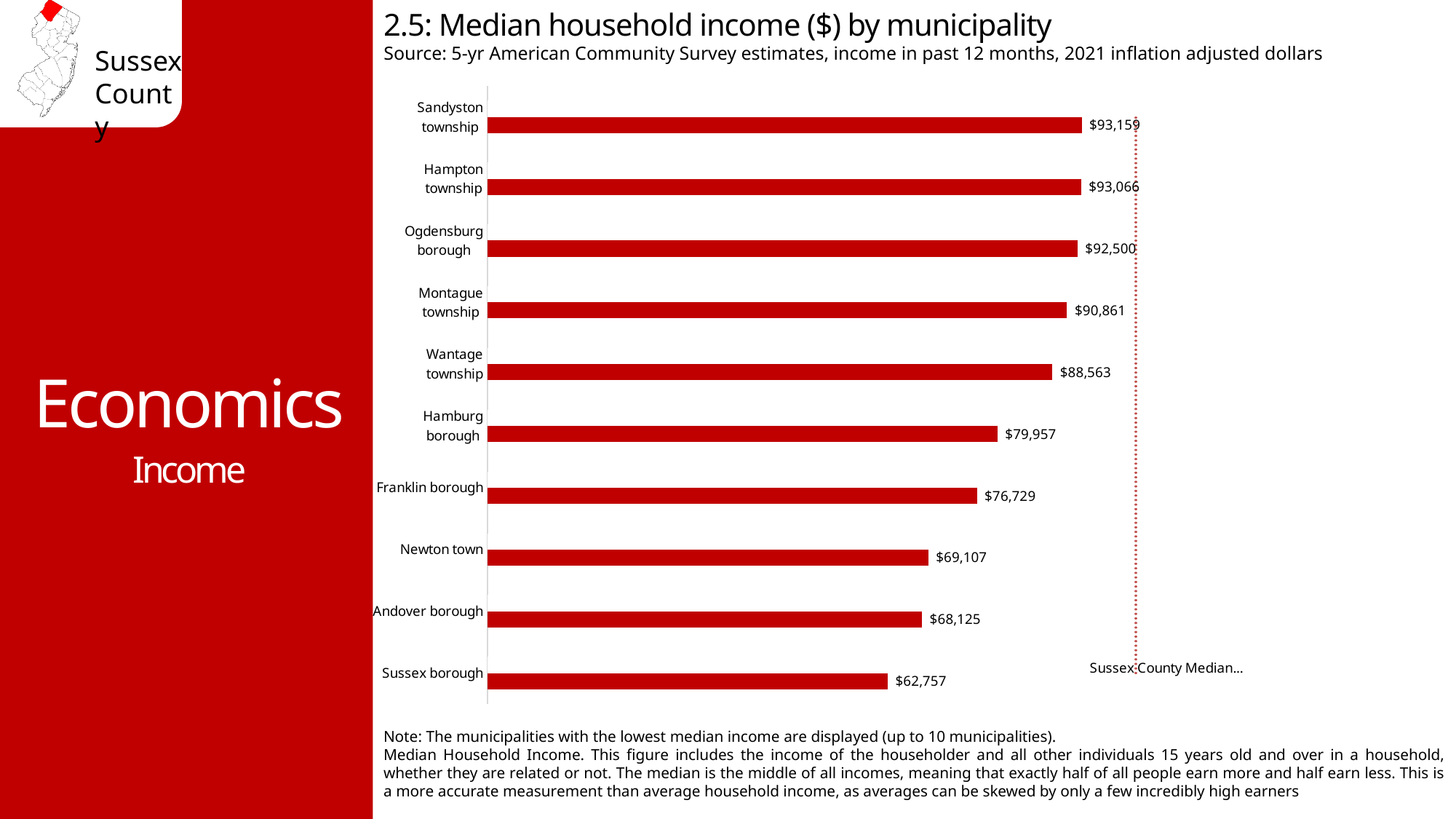
What is the median household income for Sandyston township? $93,159 How many municipalities are shown on the chart? 10 What type of chart is used to show median household income by municipality? Bar chart What does the dotted vertical line on the chart represent? Sussex County Median What is the median household income for Hamburg borough? $79,957 Which has a higher median household income, Franklin borough or Montague township? Montague township Which municipality has the highest median household income on the chart? Sandyston township What is the median household income for Newton town? $69,107 What is the difference in median household income between Wantage township and Sussex borough? $25,806 What is the difference in median household income between Newton town and Andover borough? $982 What is the median household income for Ogdensburg borough? $92,500 Which municipality has the lowest median household income on the chart? Sussex borough